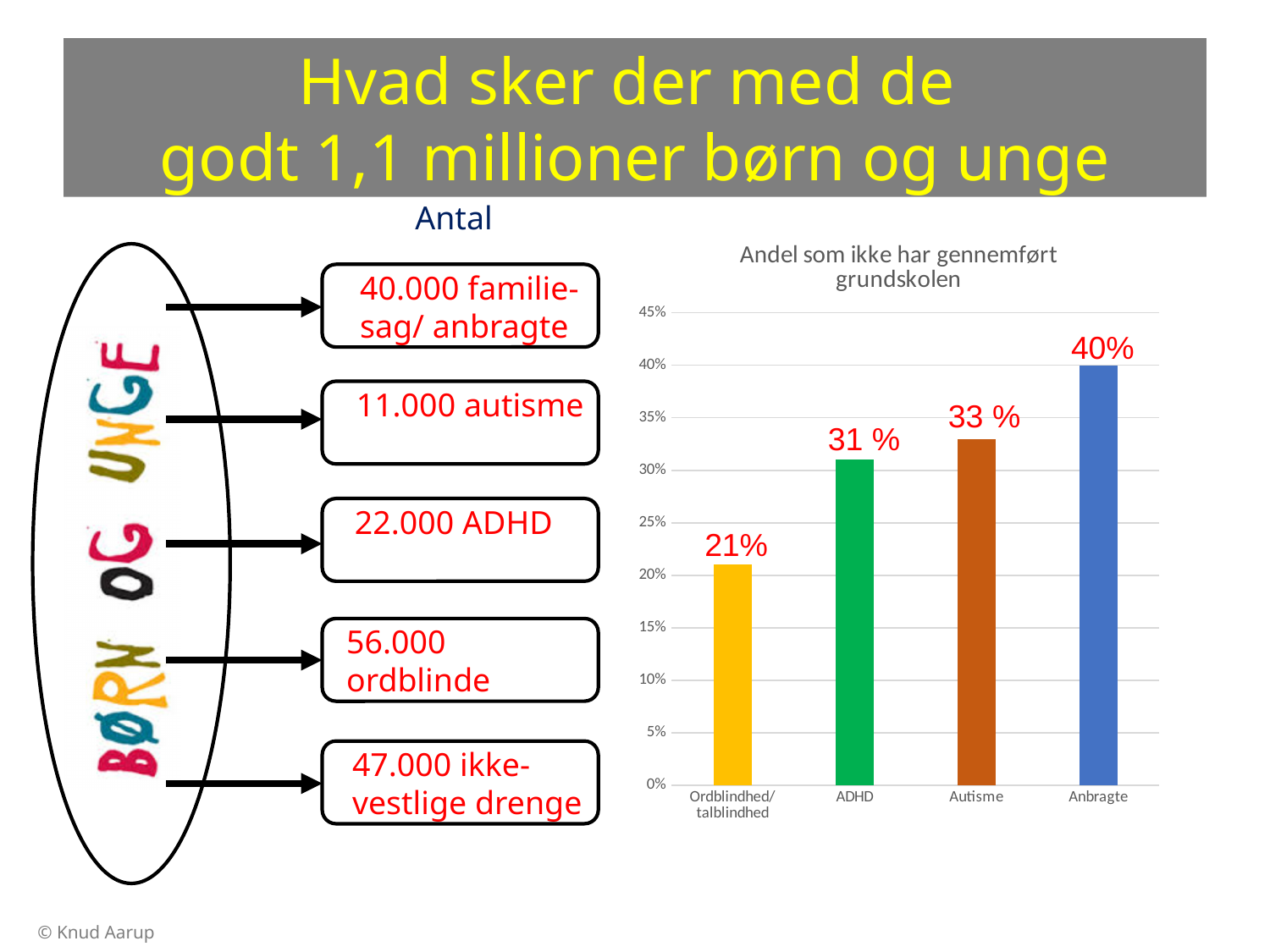
Which is larger, the value for ADHD or the value for Autisme? Autisme What kind of chart is shown on the slide? bar chart What is the value for Anbragte in the chart? 40% What is the value for ADHD in the chart? 31 % What is the difference between the values for Anbragte and Ordblindhed/talblindhed? 19 percentage points What is the value for Autisme in the chart? 33 % How many categories are shown in the chart? 4 Which category has the highest value in the chart? Anbragte What is the title of the chart? Andel som ikke har gennemført grundskolen Which category has the lowest value in the chart? Ordblindhed/talblindhed What is the value for Ordblindhed/talblindhed in the chart? 21% Is the value for ADHD greater or less than 30%? greater